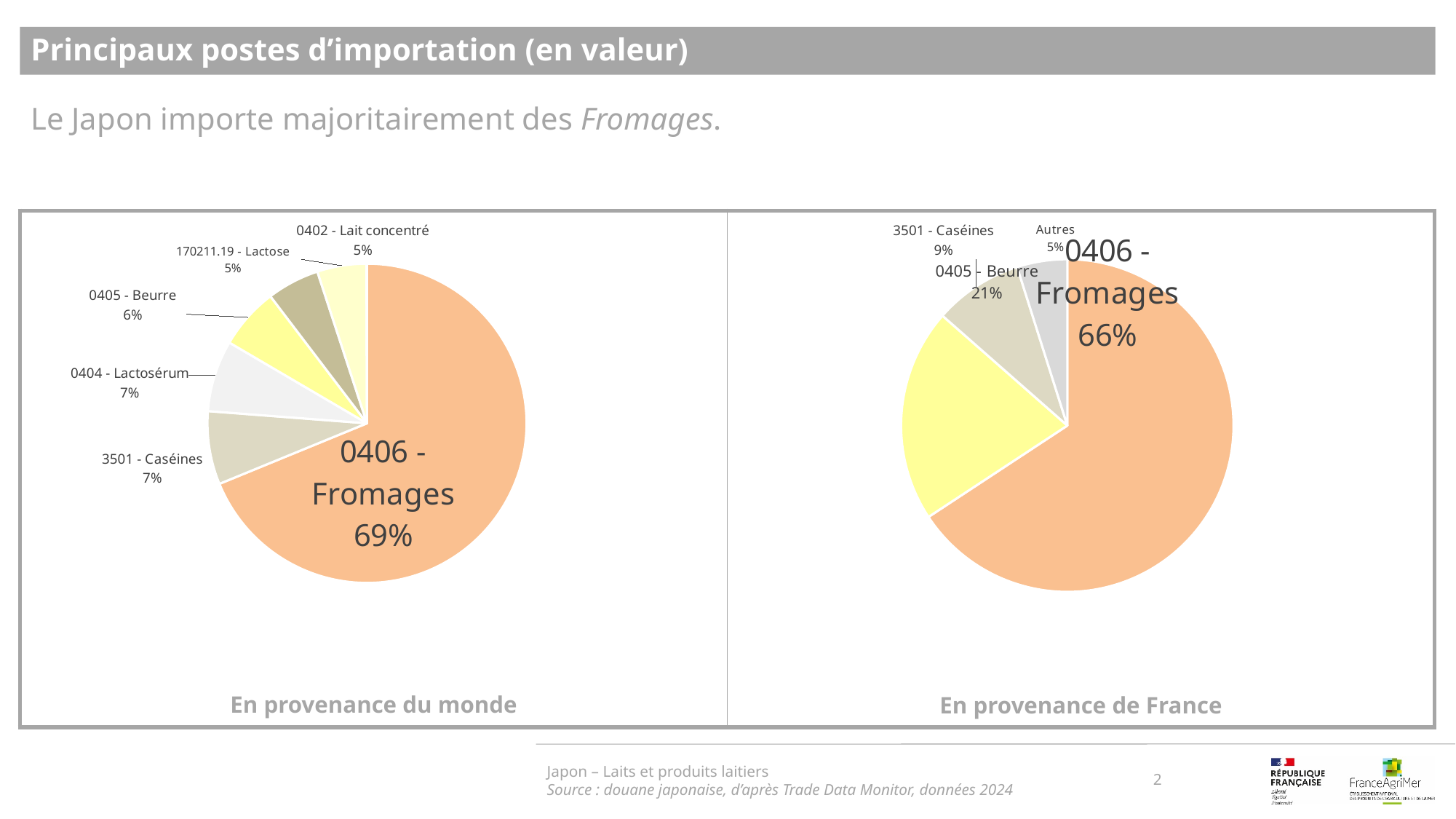
In the 'En provenance du monde' pie chart, which category has the largest share? 0406 - Fromages In the 'En provenance de France' pie chart, which category has the smallest share? Autres How many slices does the 'En provenance du monde' pie chart have? 6 In the 'En provenance du monde' pie chart, what is the share of 0404 - Lactosérum? 7% How many slices does the 'En provenance de France' pie chart have? 4 In the 'En provenance de France' pie chart, what share does 0405 - Beurre have? 21% In the 'En provenance de France' pie chart, what is the share of 3501 - Caséines? 9% In the 'En provenance du monde' pie chart, which is larger: the share of 0405 - Beurre or the share of 0402 - Lait concentré? 0405 - Beurre In the 'En provenance du monde' pie chart, what share does 0406 - Fromages have? 69% What type of chart is used on the left side of the slide, 'En provenance du monde'? Pie chart In the 'En provenance de France' pie chart, what is the difference between the shares of 0406 - Fromages and 0405 - Beurre? 45% What is the title of the chart on the right side of the slide? En provenance de France